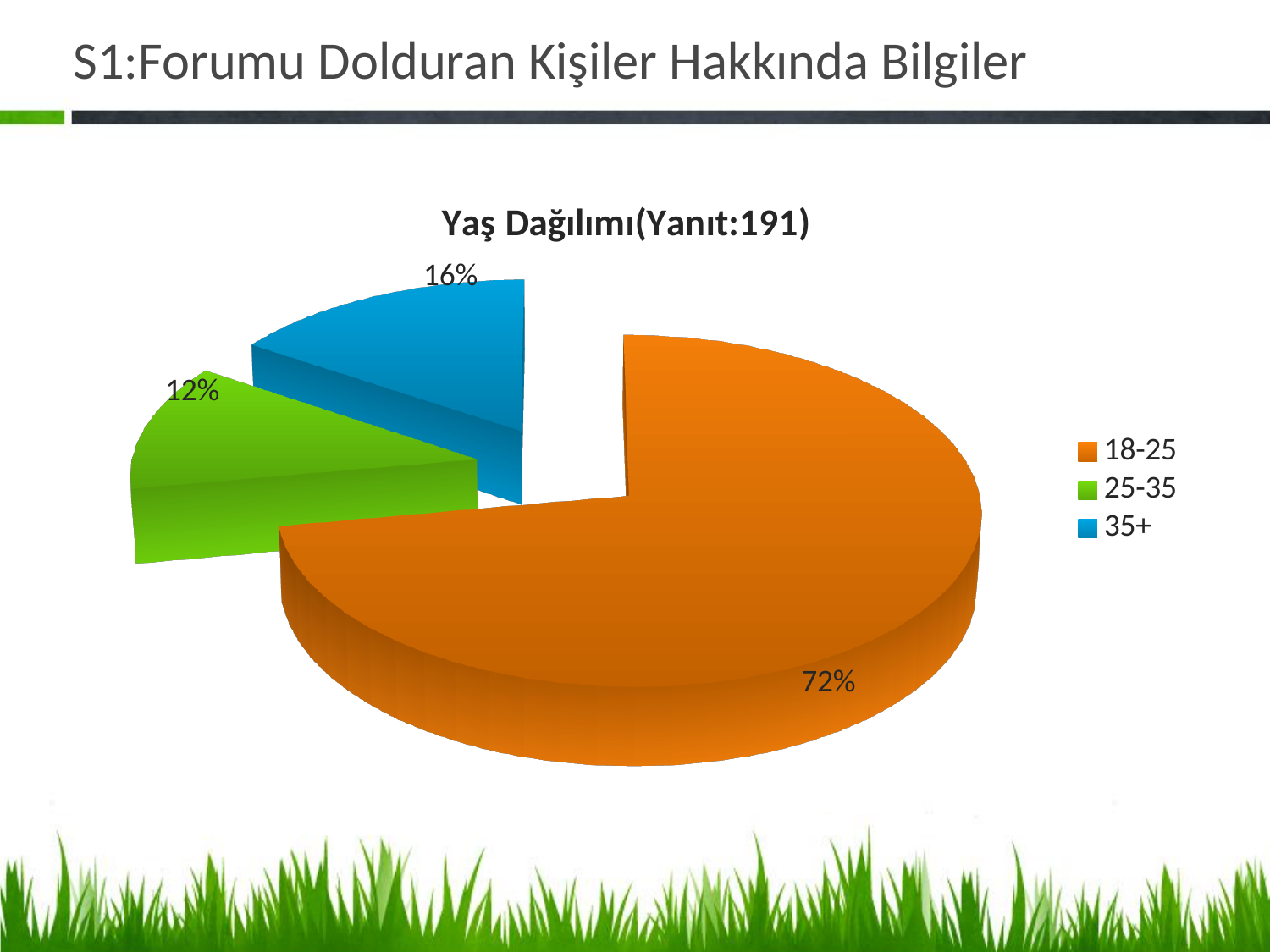
Which age group has the largest share of the pie? 18-25 What share of the pie does the 25-35 age group have? 12% How many age groups are shown in the pie chart? 3 What is the difference in percentage points between the 18-25 and 35+ shares? 56 Which age group has the smallest share of the pie? 25-35 What kind of chart is shown on the slide? Pie chart Which colour represents the 35+ age group in the legend? Blue What is the difference in percentage points between the 35+ and 25-35 shares? 4 Which has a larger share, 25-35 or 35+? 35+ What share of the pie does the 18-25 age group have? 72% What is the title of the chart? Yaş Dağılımı(Yanıt:191) What share of the pie does the 35+ age group have? 16%